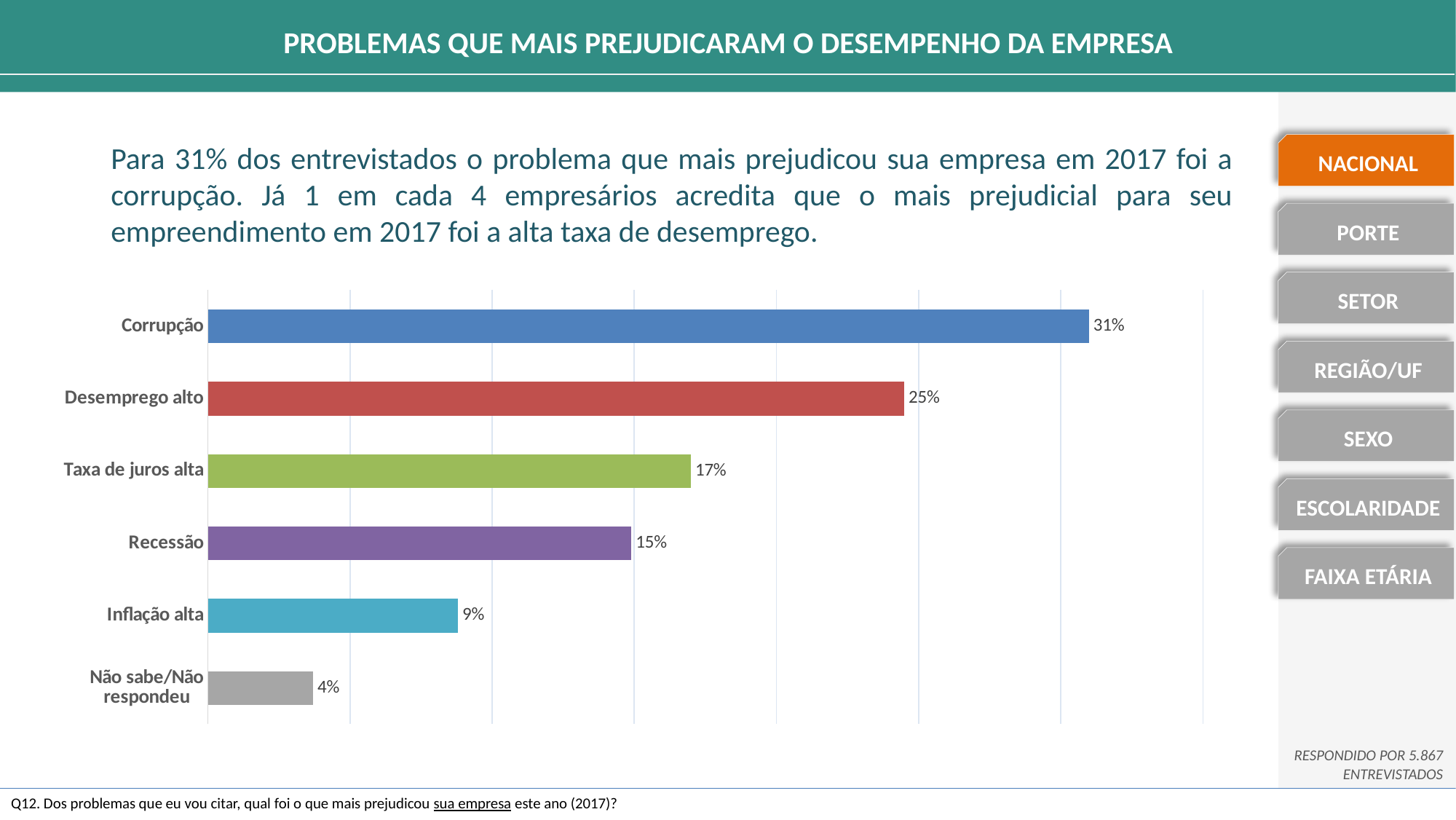
What kind of chart is shown on the slide? Bar chart What is the value for Inflação alta? 9% What is the value for Taxa de juros alta? 17% What is the value for Desemprego alto? 25% Which category has the highest value? Corrupção What is the difference between the values for Taxa de juros alta and Recessão? 2% Which category has the lowest value? Não sabe/Não respondeu How many categories are shown in the chart? 6 What is the value for Corrupção? 31% Which is larger, the value for Recessão or the value for Inflação alta? Recessão What colour is the bar for Recessão? Purple What is the difference between the values for Corrupção and Desemprego alto? 6%